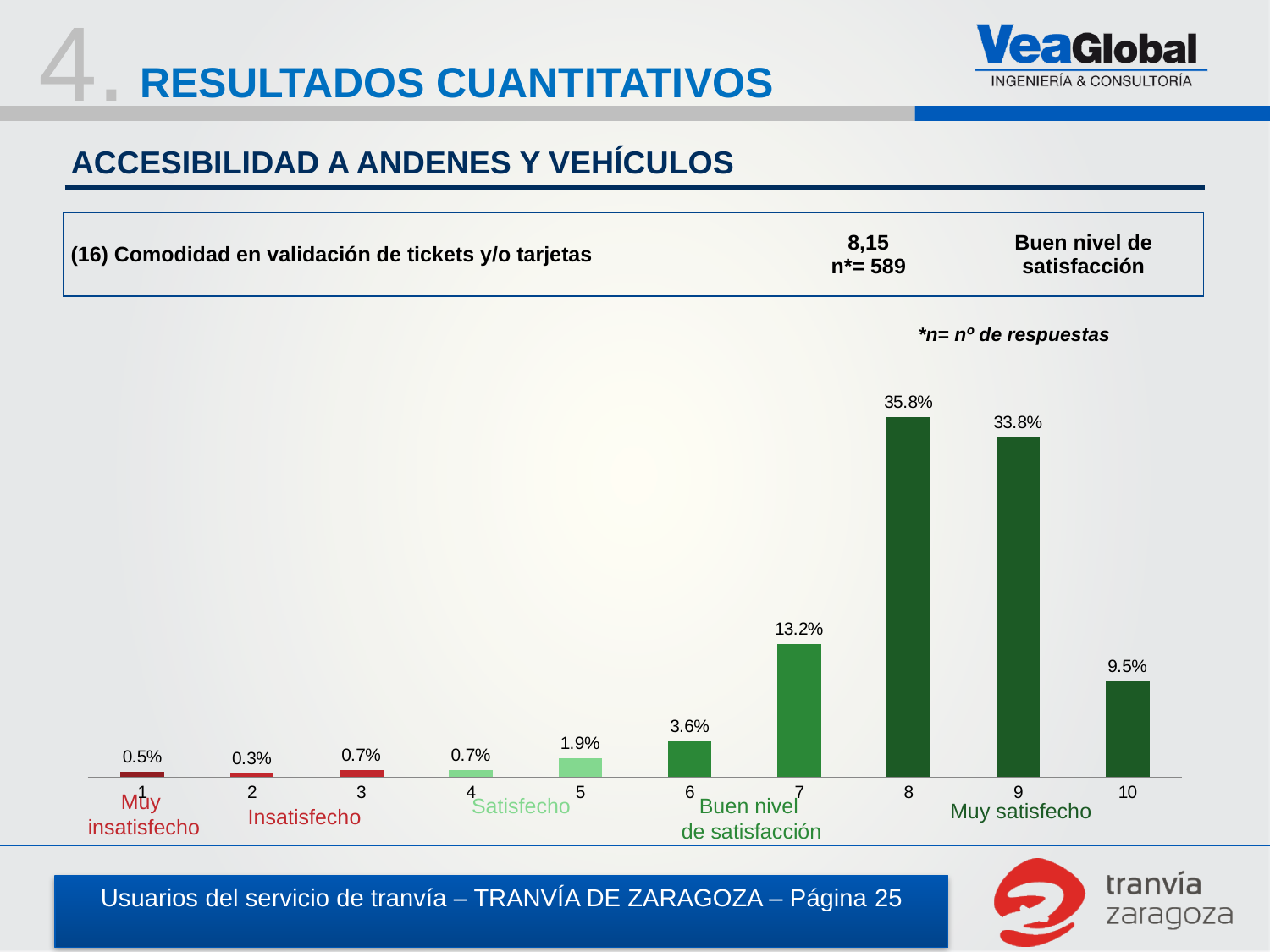
How many rating categories are shown on the x axis? 10 Which has a larger percentage, rating 6 or rating 5? 6 What is the difference between the percentages for ratings 7 and 10? 3.7% What is the average score shown for question (16) Comodidad en validación de tickets y/o tarjetas? 8,15 Which rating has the lowest percentage of responses? 2 What percentage of respondents gave a rating of 10? 9.5% What is the value shown for rating 7? 13.2% What is the difference between the percentages for ratings 8 and 9? 2.0% Which rating has the highest percentage of responses? 8 What percentage of respondents gave a rating of 8? 35.8% What type of chart is shown on the slide? Bar chart What is the number of responses (n*) shown for this question? 589